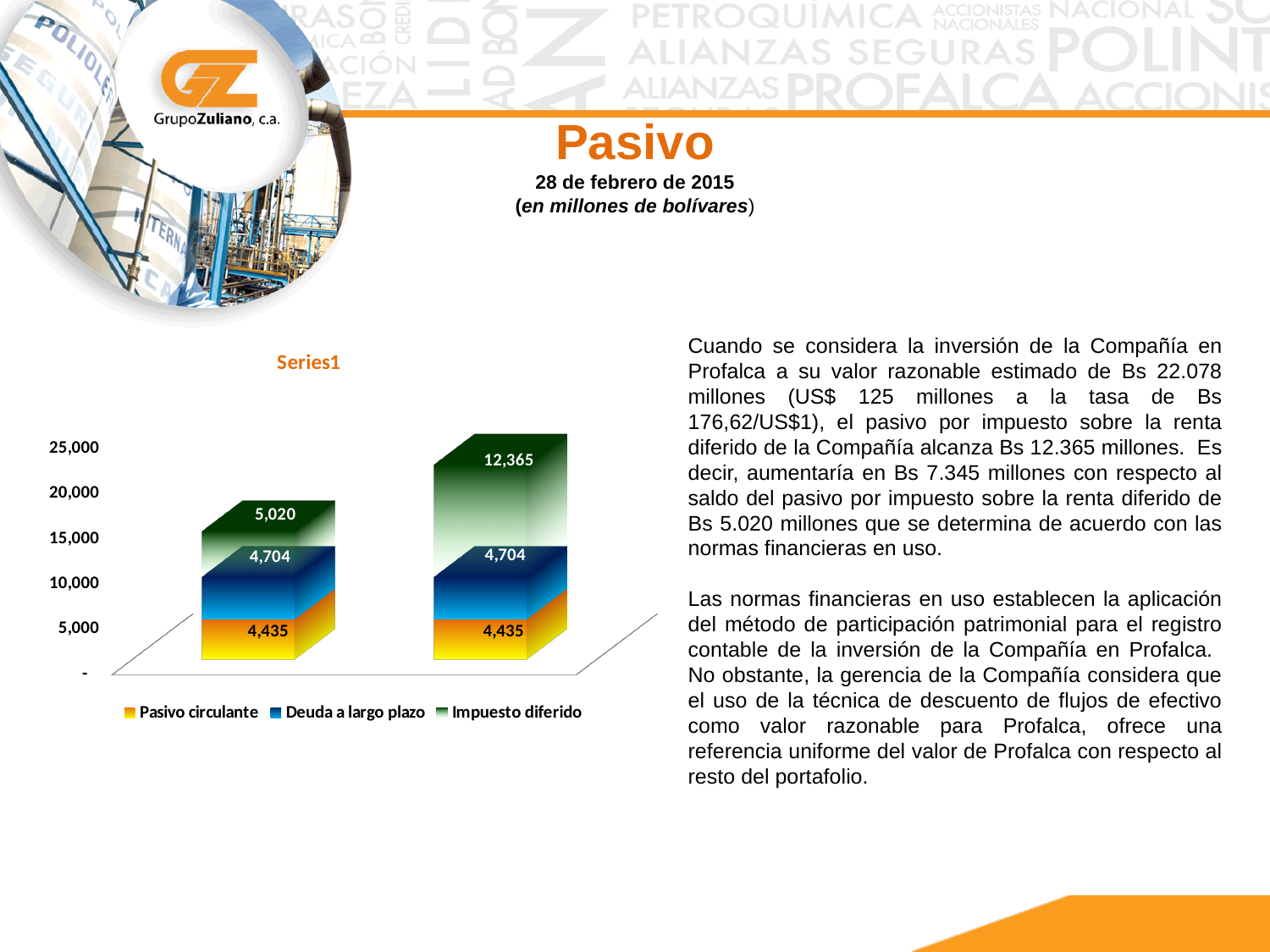
What are the three legend entries of the chart? Pasivo circulante, Deuda a largo plazo, Impuesto diferido What is the value of Impuesto diferido in the right bar? 12,365 What is the total of the left stacked bar? 14,159 What is the total of the right stacked bar? 21,504 Which series is the largest segment in the right bar? Impuesto diferido By how much does Impuesto diferido in the right bar exceed Impuesto diferido in the left bar? 7,345 How many series does the chart legend list? 3 What is the value of Pasivo circulante in the left bar? 4,435 What is the value of Impuesto diferido in the left bar? 5,020 How many stacked bars are plotted in the chart? 2 What kind of chart is shown on the slide? Stacked bar chart What is the value of Deuda a largo plazo in the right bar? 4,704